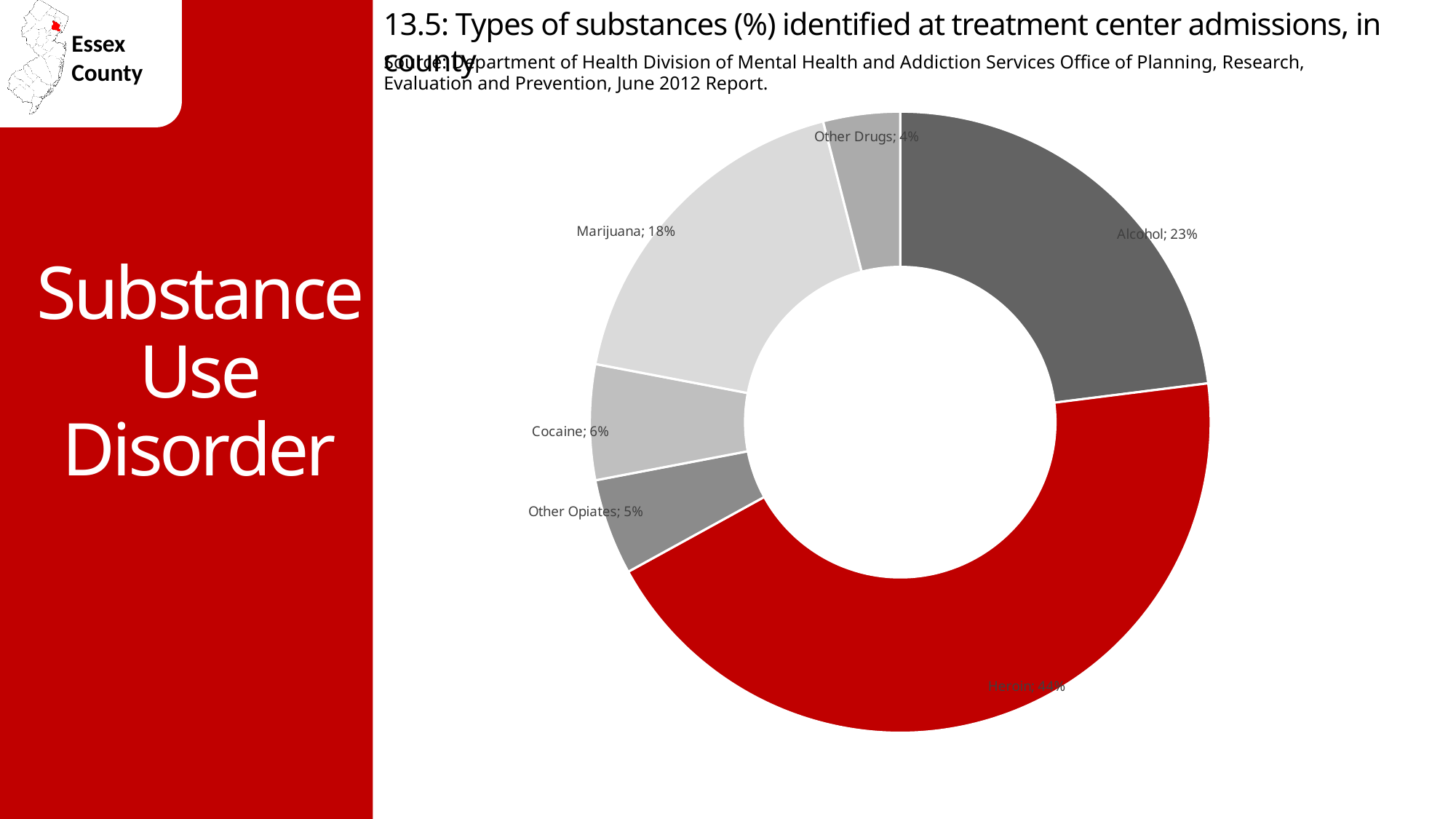
What percentage is shown for Cocaine? 6% What is the difference in percentage points between Alcohol and Marijuana? 5 How many substance categories are shown in the chart? 6 Which substance accounts for the largest share of admissions? Heroin Which substance accounts for the smallest share of admissions? Other Drugs What percentage is shown for Other Opiates? 5% What percentage of treatment center admissions is attributed to Alcohol? 23% Which has a larger share, Cocaine or Other Opiates? Cocaine What percentage is shown for Other Drugs? 4% What percentage is shown for Marijuana? 18% Which slice of the chart is coloured red? Heroin What kind of chart is used to show the types of substances? Doughnut (pie) chart